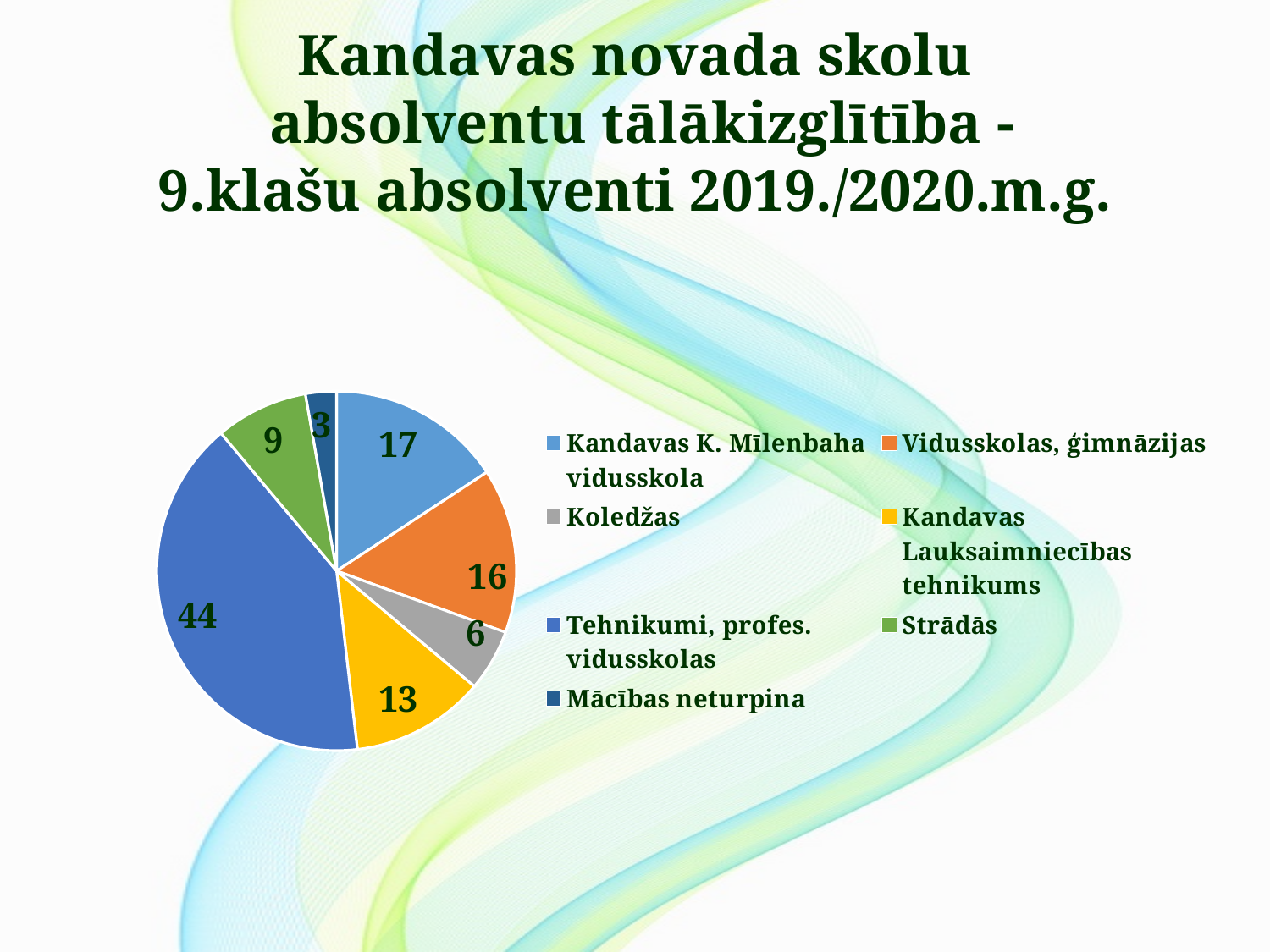
What is the total of all the values shown in the pie chart? 108 Which category has the smallest slice of the pie? Mācības neturpina Which is larger, the value for Vidusskolas, ģimnāzijas or the value for Strādās? Vidusskolas, ģimnāzijas What is the value for Mācības neturpina? 3 What colour is the slice for Strādās? green What is the difference between the values for Tehnikumi, profes. vidusskolas and Kandavas Lauksaimniecības tehnikums? 31 What is the value for Kandavas K. Mīlenbaha vidusskola? 17 Which category has the largest slice of the pie? Tehnikumi, profes. vidusskolas What is the value for Koledžas? 6 What is the value for Tehnikumi, profes. vidusskolas? 44 How many slices does the pie chart have? 7 What kind of chart is shown on the slide? pie chart